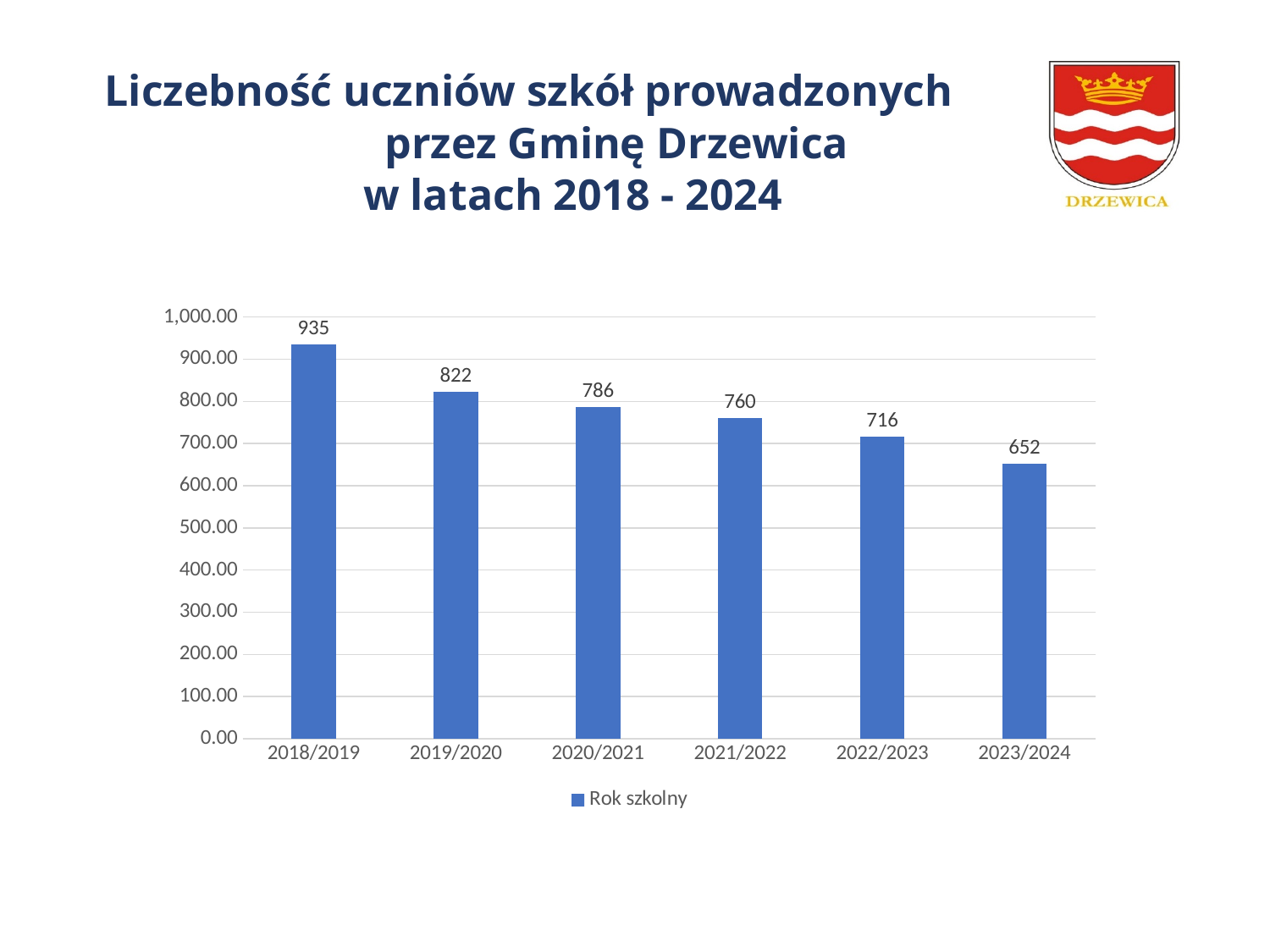
What is the difference between the number of students in 2019/2020 and 2020/2021? 36 Which school year has the highest number of students? 2018/2019 What is the difference between the number of students in 2018/2019 and 2023/2024? 283 What kind of chart is shown on the slide? bar chart Which school year has more students, 2020/2021 or 2022/2023? 2020/2021 Which school year has the lowest number of students? 2023/2024 What is the number of students for the 2018/2019 school year? 935 Do the values rise or fall from 2018/2019 to 2023/2024? fall What is the number of students for the 2021/2022 school year? 760 Is the value for 2022/2023 greater or less than 700.00? greater What is the number of students for the 2023/2024 school year? 652 How many school years are shown on the chart? 6